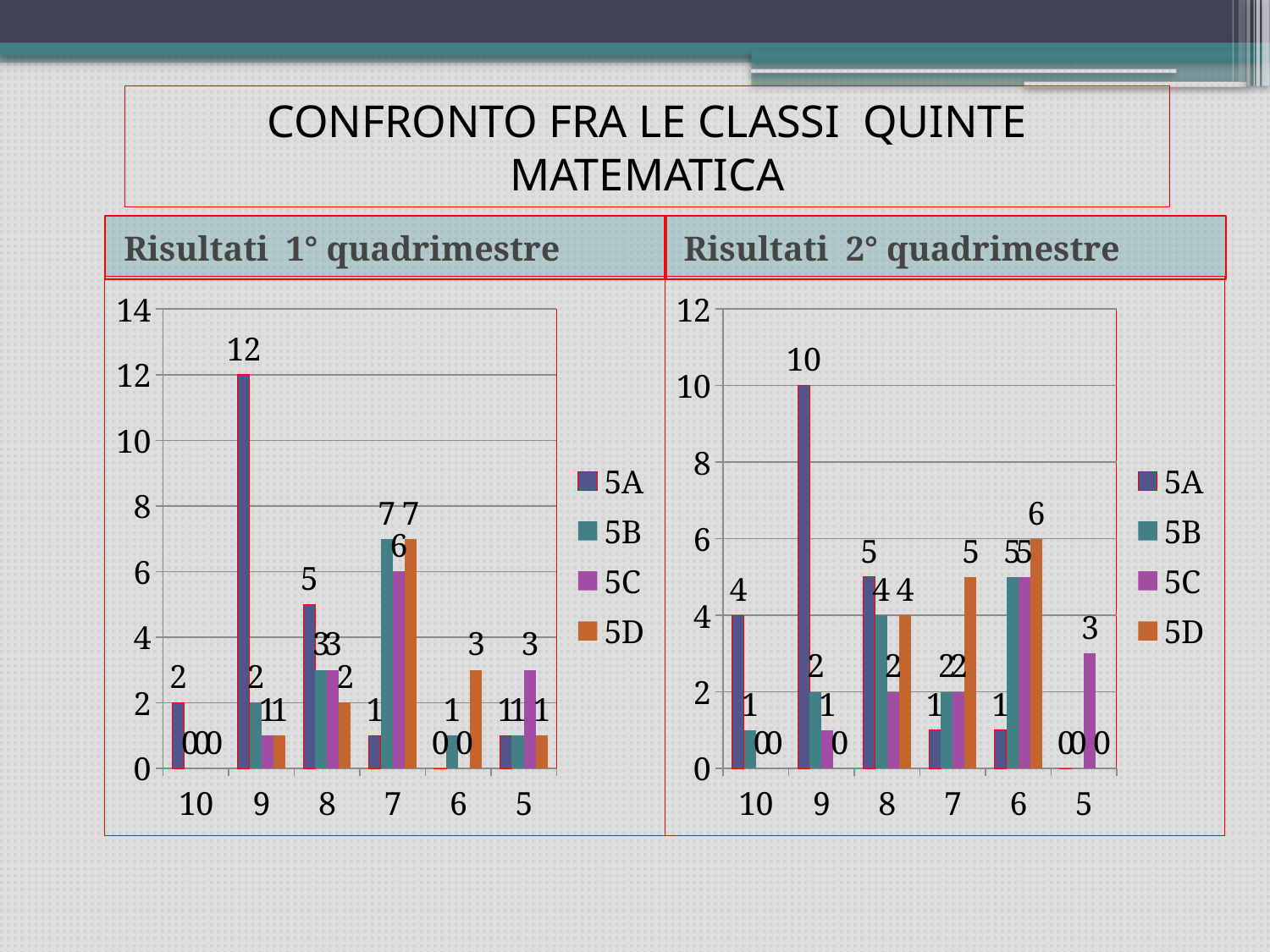
How many series does the legend of the 'Risultati 1° quadrimestre' chart list? 4 In the 'Risultati 1° quadrimestre' chart, what is the difference between the 5A value at grade 9 and the 5A value at grade 8? 7 In the 'Risultati 1° quadrimestre' chart, what is the value for 5A at grade 9? 12 In the 'Risultati 2° quadrimestre' chart, what is the difference between the 5D value at grade 6 and the 5D value at grade 8? 2 In the 'Risultati 2° quadrimestre' chart, what is the value for 5A at grade 9? 10 In the 'Risultati 1° quadrimestre' chart, what is the value for 5D at grade 6? 3 In the 'Risultati 2° quadrimestre' chart, what is the value for 5D at grade 6? 6 How many grade categories are shown on the x axis of the 'Risultati 2° quadrimestre' chart? 6 In the 'Risultati 2° quadrimestre' chart, which grade has the highest value for 5C? 6 In the 'Risultati 1° quadrimestre' chart, which grade has the highest value for 5A? 9 What type of chart is the 'Risultati 1° quadrimestre' chart? Bar chart In the 'Risultati 2° quadrimestre' chart, which is larger at grade 7: the value for 5A or the value for 5D? 5D